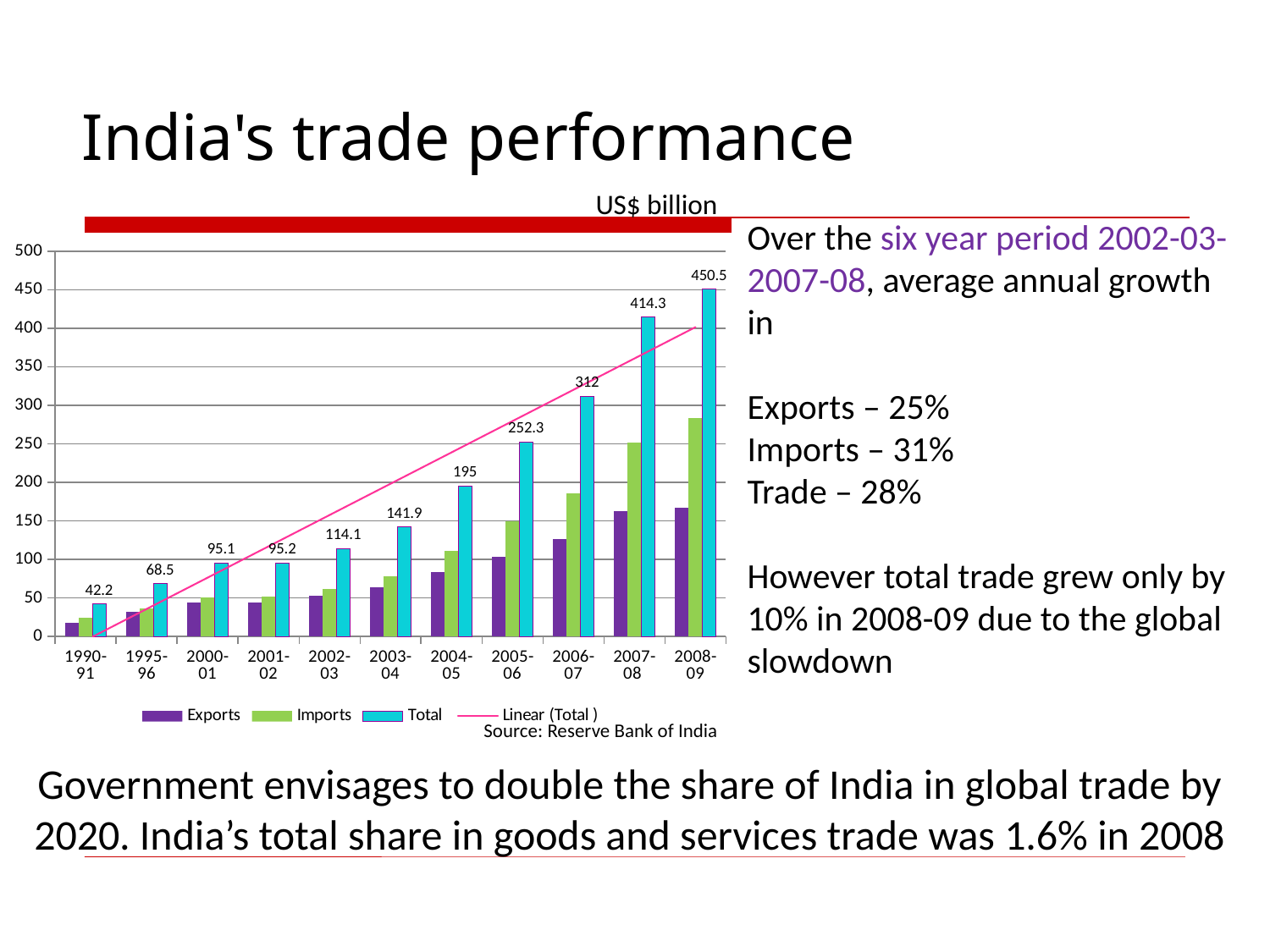
How many entries does the legend list? 4 What is the Total value for 2004-05? 195 How many periods are shown on the x axis? 11 What kind of chart is shown on the slide? Bar chart What is the Total value for 1990-91? 42.2 Which period has the lowest Total value? 1990-91 Which is larger, the Total value for 2003-04 or for 2002-03? 2003-04 Is the Exports value for 2008-09 greater or less than 150? greater What is the Total value for 2008-09? 450.5 Which period has the highest Total value? 2008-09 What is the difference between the Total values for 2007-08 and 2006-07? 102.3 Is the Imports value for 2007-08 greater or less than 300? less